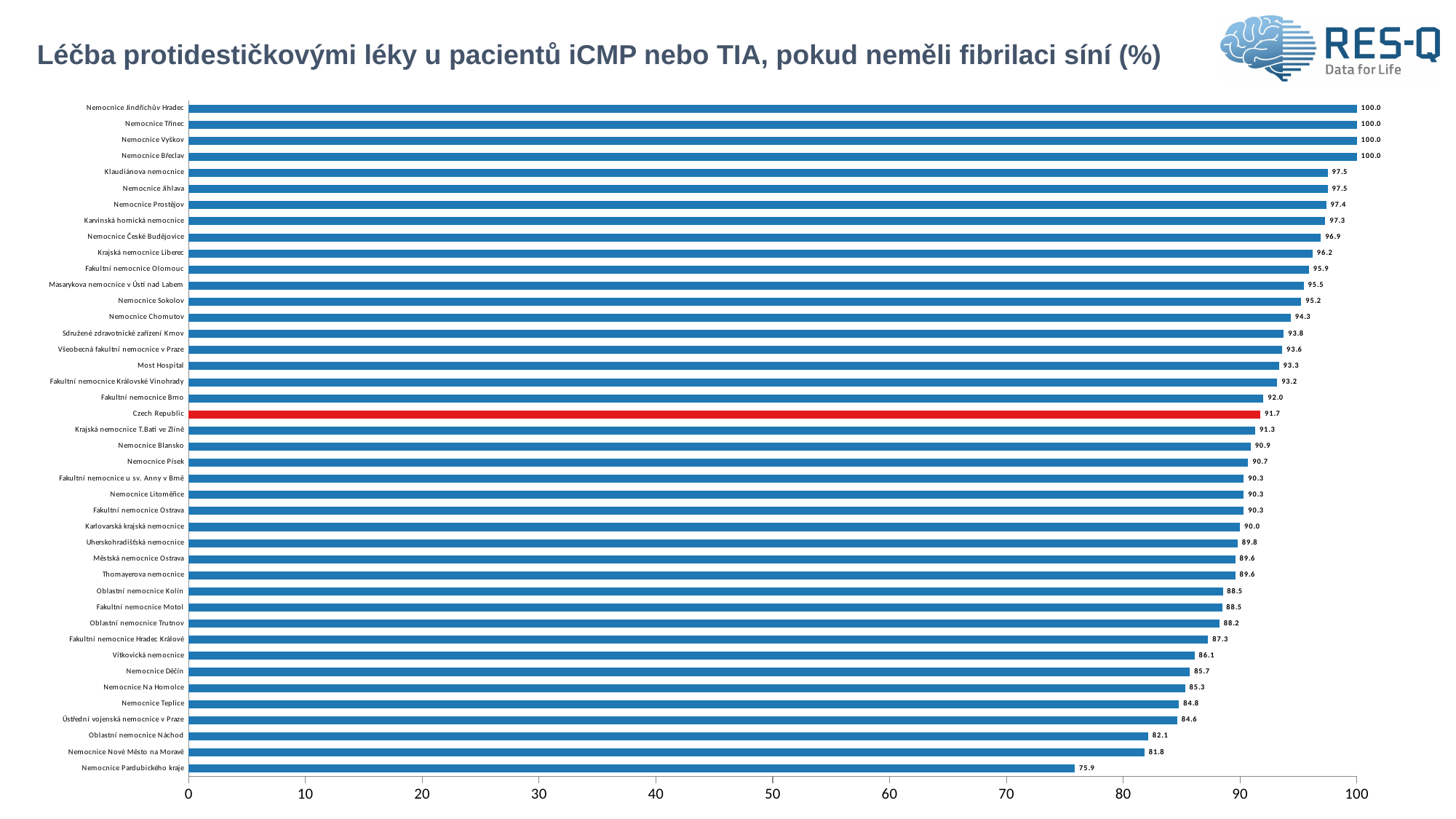
What is the difference between the values for Czech Republic and Nemocnice Pardubického kraje? 15.8 Which bar is highlighted in red? Czech Republic What is the lowest value shown on the chart? 75.9 What is the value for Nemocnice Sokolov? 95.2 What is the difference between the values for Nemocnice Jihlava and Fakultní nemocnice Brno? 5.5 What is the highest value shown on the chart? 100.0 Which is larger, the value for Nemocnice Chomutov or the value for Nemocnice Teplice? Nemocnice Chomutov Which hospital has the lowest value? Nemocnice Pardubického kraje What kind of chart is shown on the slide? bar chart What is the value for Fakultní nemocnice Motol? 88.5 How many bars are shown on the chart? 42 What is the value for Czech Republic? 91.7